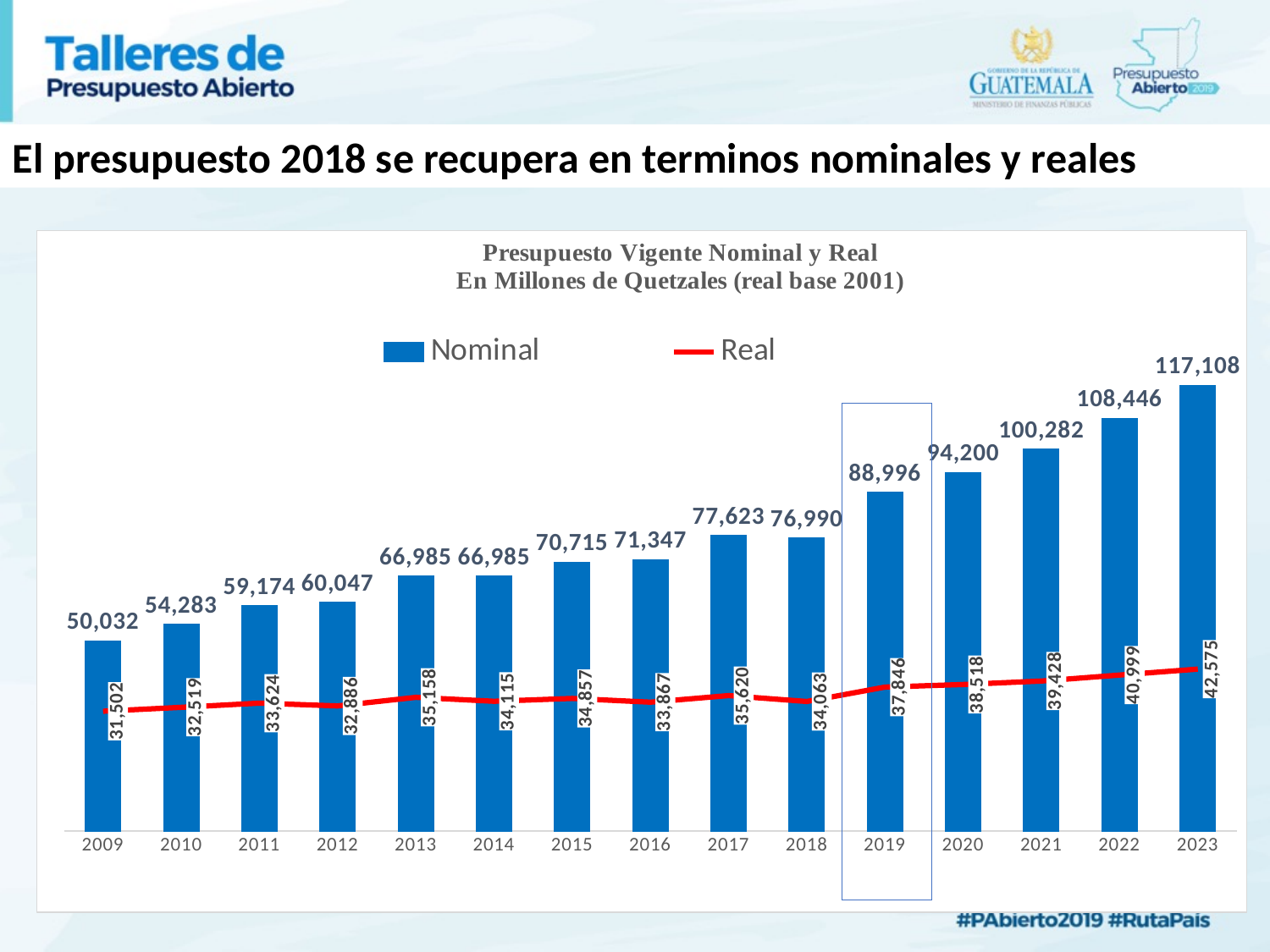
Which year has the larger Nominal value, 2017 or 2018? 2017 Which series is drawn as a red line? Real Which year has the lowest Real value? 2009 How many series does the legend list? 2 What is the Real value for 2018? 34,063 What is the Nominal value for 2019? 88,996 What is the difference between the Nominal values for 2023 and 2022? 8,662 Which year has the highest Nominal value? 2023 What kind of chart is shown? Bar chart with a line series Do the Nominal values generally rise or fall from 2009 to 2023? Rise How many years are shown on the x axis? 15 What is the difference between the Real values for 2019 and 2018? 3,783